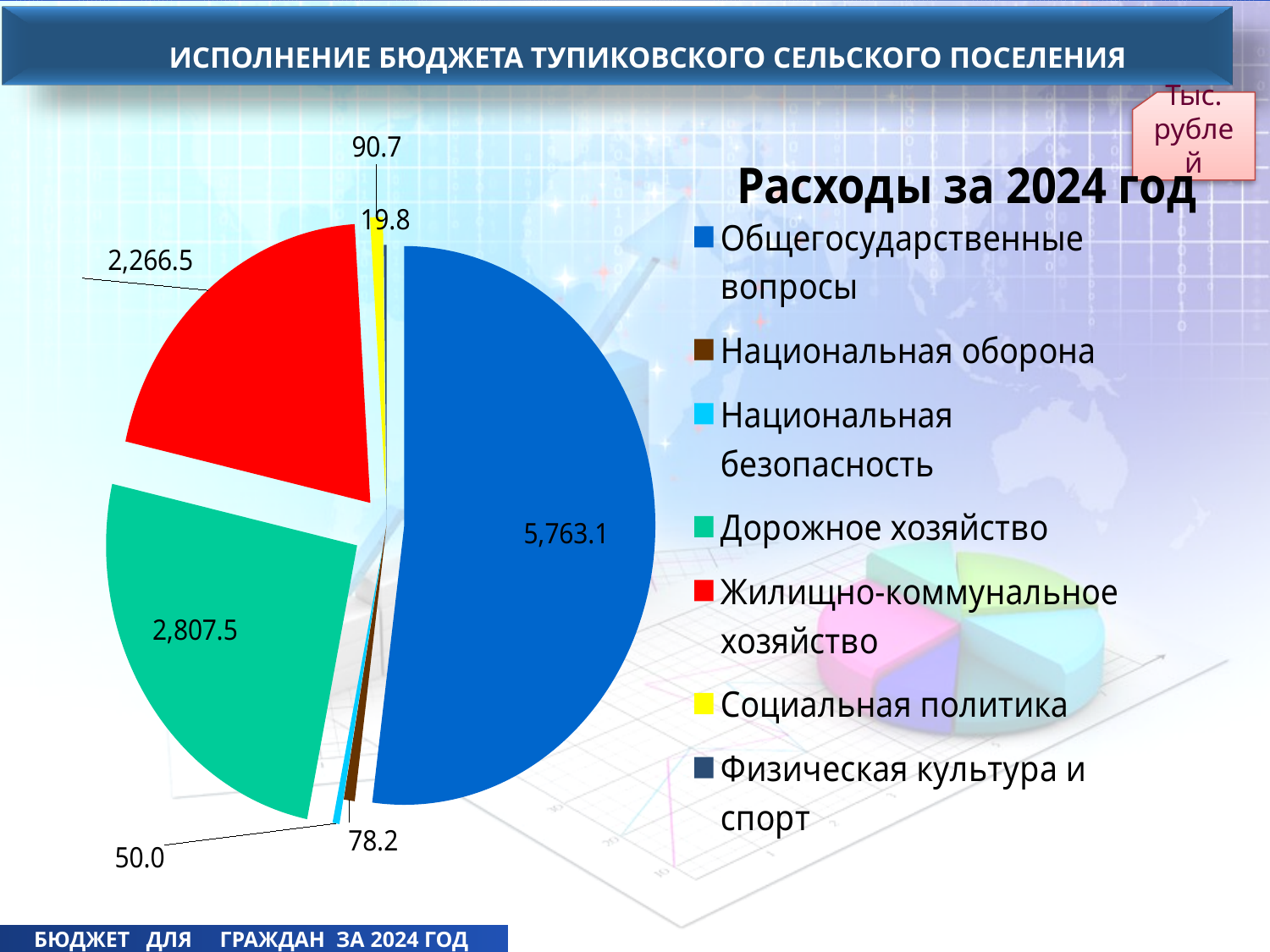
What is the title of the chart? Расходы за 2024 год What is the value for Дорожное хозяйство? 2,807.5 How many categories does the legend of the pie chart list? 7 What is the value for Жилищно-коммунальное хозяйство? 2,266.5 What is the value for Общегосударственные вопросы? 5,763.1 What is the difference between the values for Дорожное хозяйство and Жилищно-коммунальное хозяйство? 541.0 Which category has the smallest slice of the pie? Физическая культура и спорт Which is larger, the value for Национальная оборона or the value for Социальная политика? Социальная политика Which category has the largest slice of the pie? Общегосударственные вопросы What kind of chart is shown on the slide? pie chart What is the value for Социальная политика? 90.7 What is the value for Национальная безопасность? 50.0